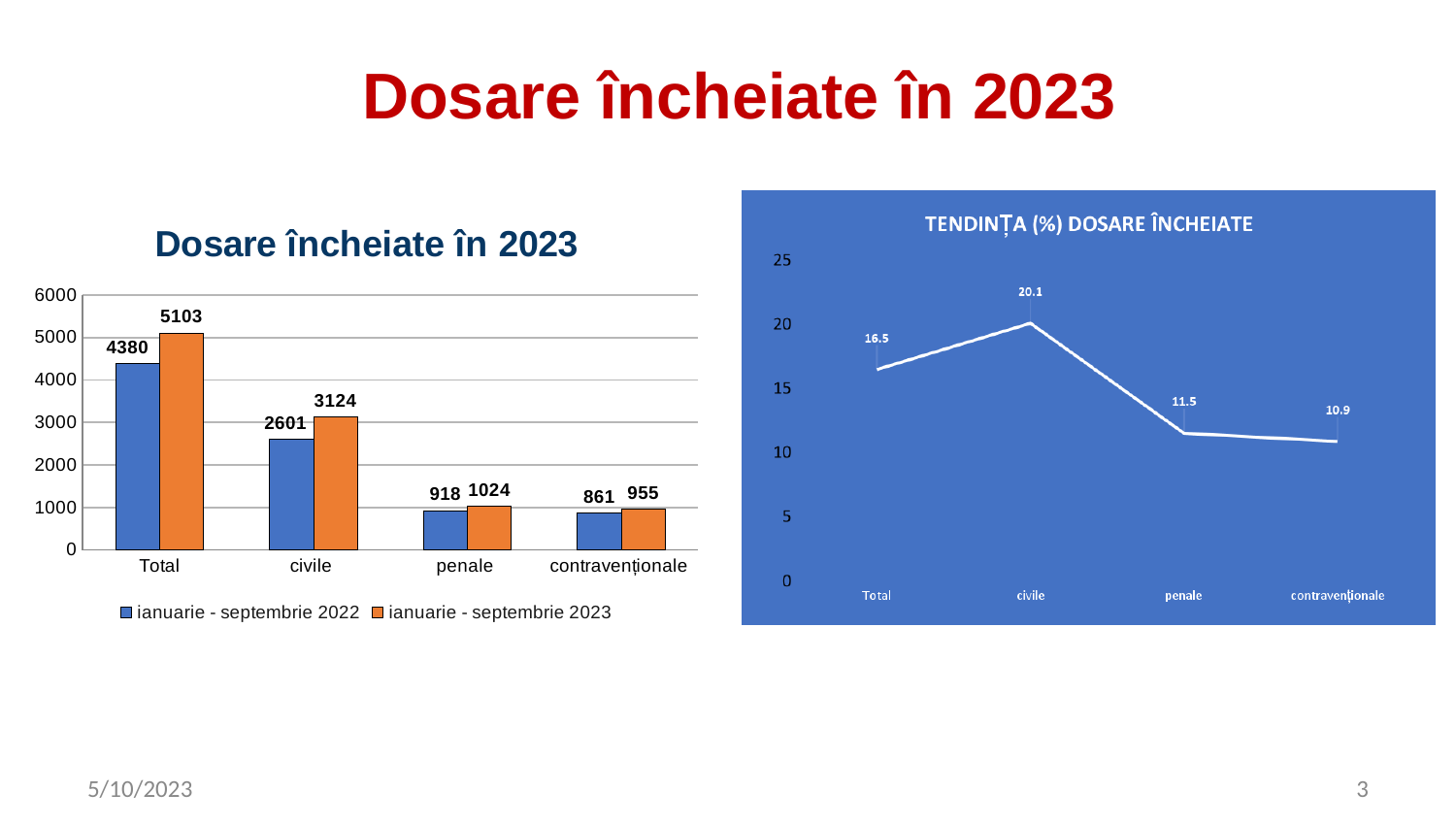
In the 'Dosare încheiate în 2023' bar chart, how many categories are shown on the x axis? 4 What kind of chart is 'TENDINȚA (%) DOSARE ÎNCHEIATE'? line chart In the 'Dosare încheiate în 2023' bar chart, what is the value for 'penale' in the 'ianuarie - septembrie 2022' series? 918 In the 'Dosare încheiate în 2023' bar chart, what is the value for 'civile' in the 'ianuarie - septembrie 2023' series? 3124 In the 'Dosare încheiate în 2023' bar chart, what is the difference between the 'Total' values for 2023 and 2022? 723 In the 'TENDINȚA (%) DOSARE ÎNCHEIATE' chart, what is the difference between the values for 'civile' and 'penale'? 8.6 In the 'Dosare încheiate în 2023' bar chart, how many series does the legend list? 2 In the 'TENDINȚA (%) DOSARE ÎNCHEIATE' chart, which category has the lowest value? contravenționale In the 'TENDINȚA (%) DOSARE ÎNCHEIATE' chart, what is the value for 'civile'? 20.1 In the 'Dosare încheiate în 2023' bar chart, which category has the lowest value in the 'ianuarie - septembrie 2023' series? contravenționale In the 'Dosare încheiate în 2023' bar chart, is the 'ianuarie - septembrie 2022' value for 'contravenționale' larger or smaller than the 'ianuarie - septembrie 2023' value for 'contravenționale'? smaller In the 'TENDINȚA (%) DOSARE ÎNCHEIATE' chart, is the value for 'Total' greater or less than 15? greater